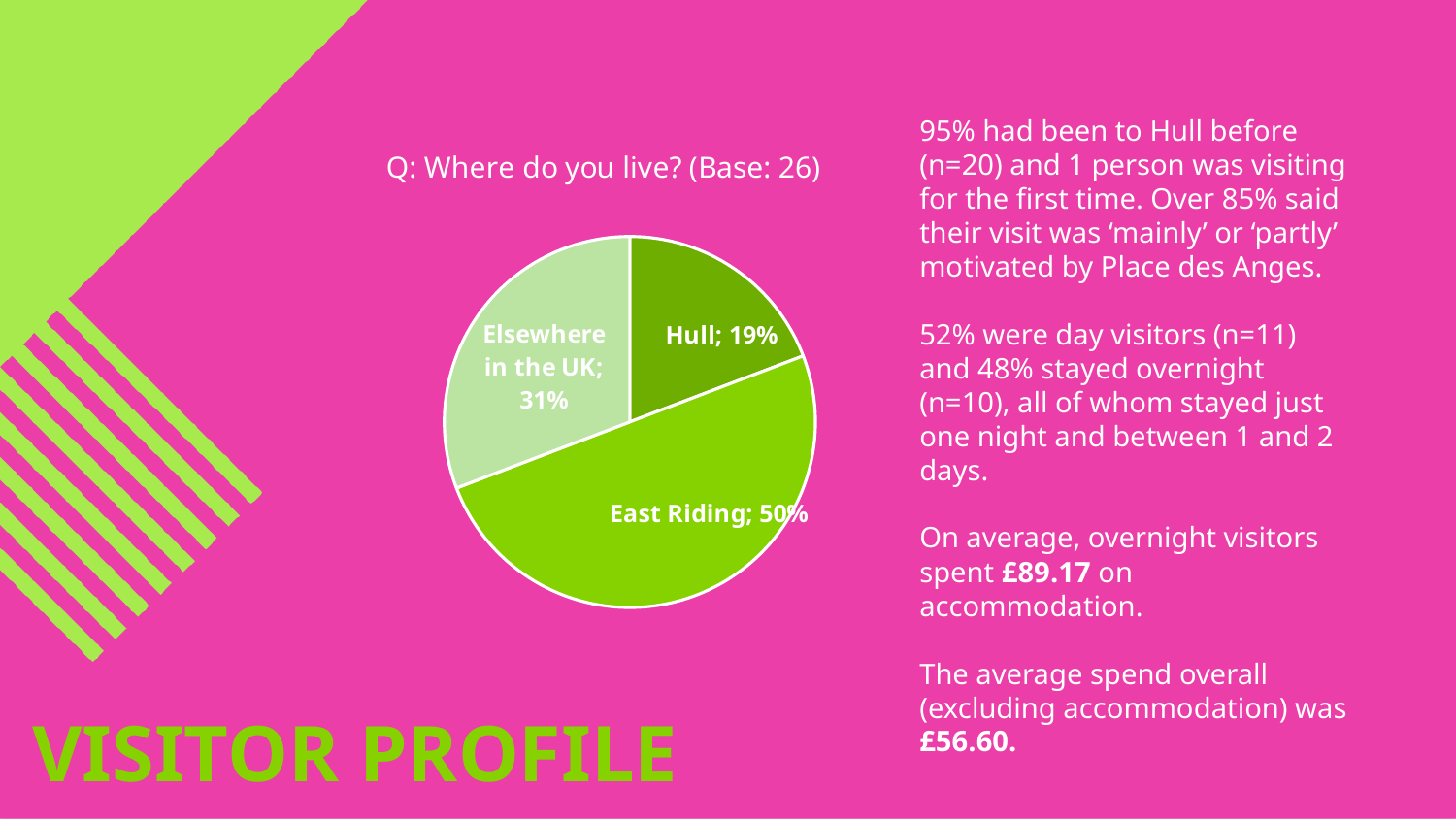
What percentage of respondents live in Hull? 19% What kind of chart is shown on the slide? pie chart What is the difference in percentage points between East Riding and Hull? 31 What is the base (number of respondents) stated in the chart title? 26 What percentage of respondents live elsewhere in the UK? 31% Which is larger, the share for Elsewhere in the UK or the share for Hull? Elsewhere in the UK What is the chart's title? Q: Where do you live? (Base: 26) What percentage of respondents live in East Riding? 50% Which category has the smallest share of the pie? Hull How many categories does the pie chart show? 3 What is the difference in percentage points between Elsewhere in the UK and Hull? 12 Which category has the largest share of the pie? East Riding